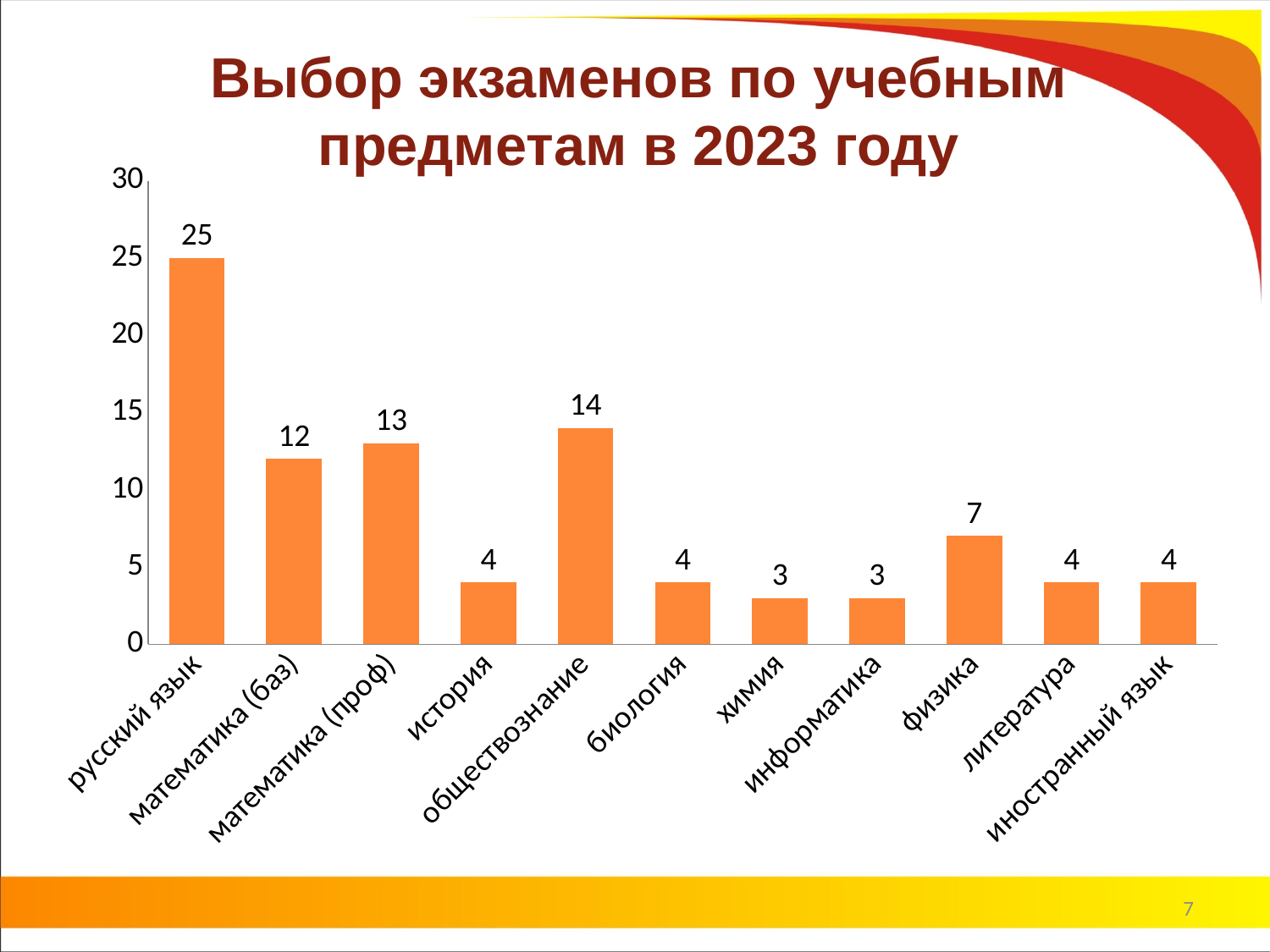
What is the difference between the values for математика (проф) and математика (баз)? 1 Which subject has the highest value? русский язык What kind of chart is shown on the slide? bar chart What value is shown for химия? 3 How many subjects are shown on the x axis? 11 Which is larger, the value for математика (проф) or the value for обществознание? обществознание What is the difference between the values for русский язык and обществознание? 11 What value is shown for русский язык? 25 What value is shown for физика? 7 What is the title of the chart on the slide? Выбор экзаменов по учебным предметам в 2023 году Which is larger, the value for физика or the value for биология? физика What value is shown for обществознание? 14